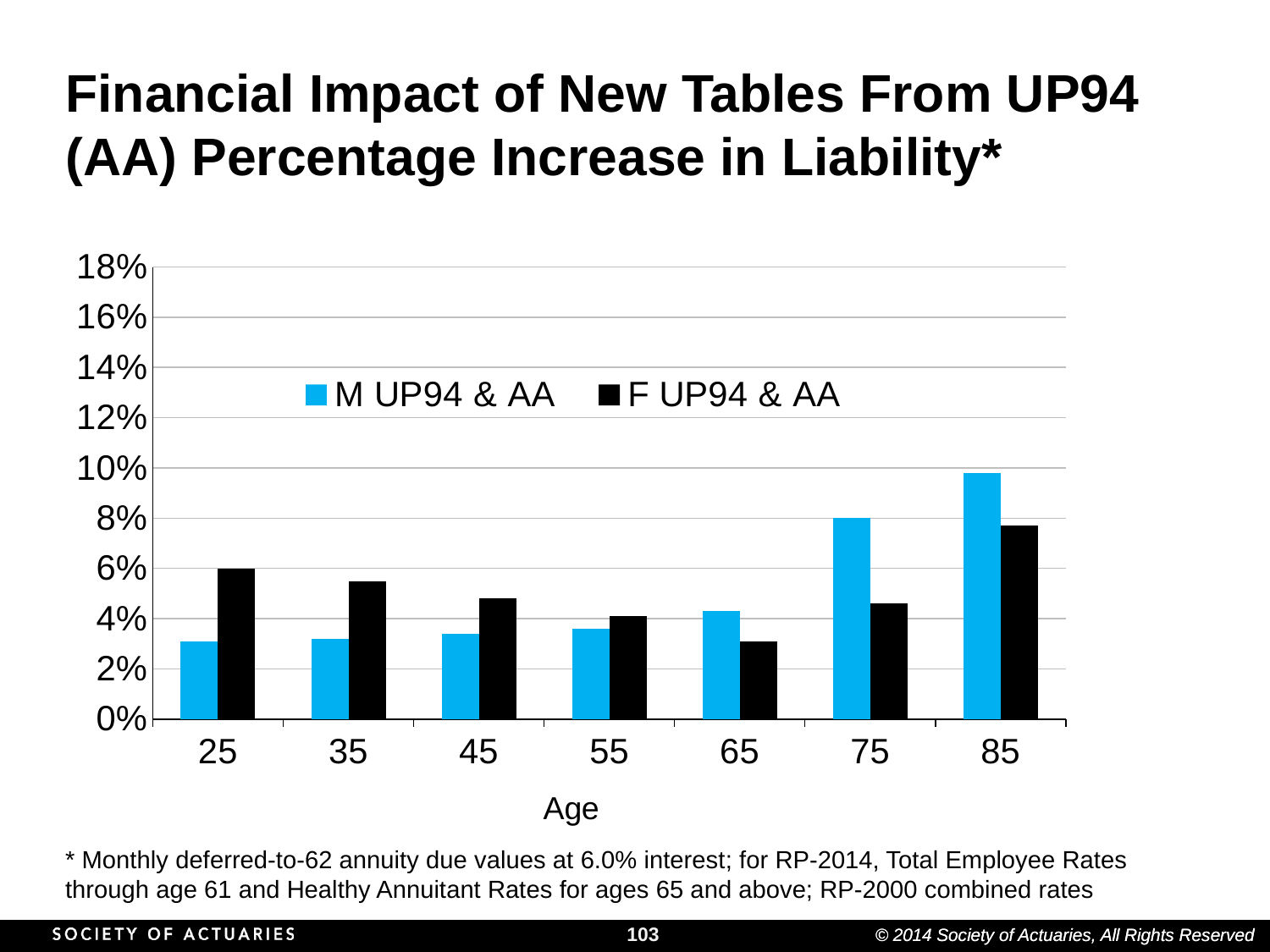
What kind of chart is shown on the slide? bar chart What is the title of the x axis? Age At which age is the M UP94 & AA value highest? 85 At age 85, which series has the larger value, M UP94 & AA or F UP94 & AA? M UP94 & AA Do the M UP94 & AA values rise or fall as age increases from 25 to 85? rise How many series does the legend list? 2 At age 25, which series has the larger value, M UP94 & AA or F UP94 & AA? F UP94 & AA Is the F UP94 & AA value at age 65 greater or less than 4%? less At which age is the F UP94 & AA value highest? 85 At which age is the F UP94 & AA value lowest? 65 How many age categories are shown on the x axis? 7 Is the M UP94 & AA value at age 85 greater or less than 8%? greater